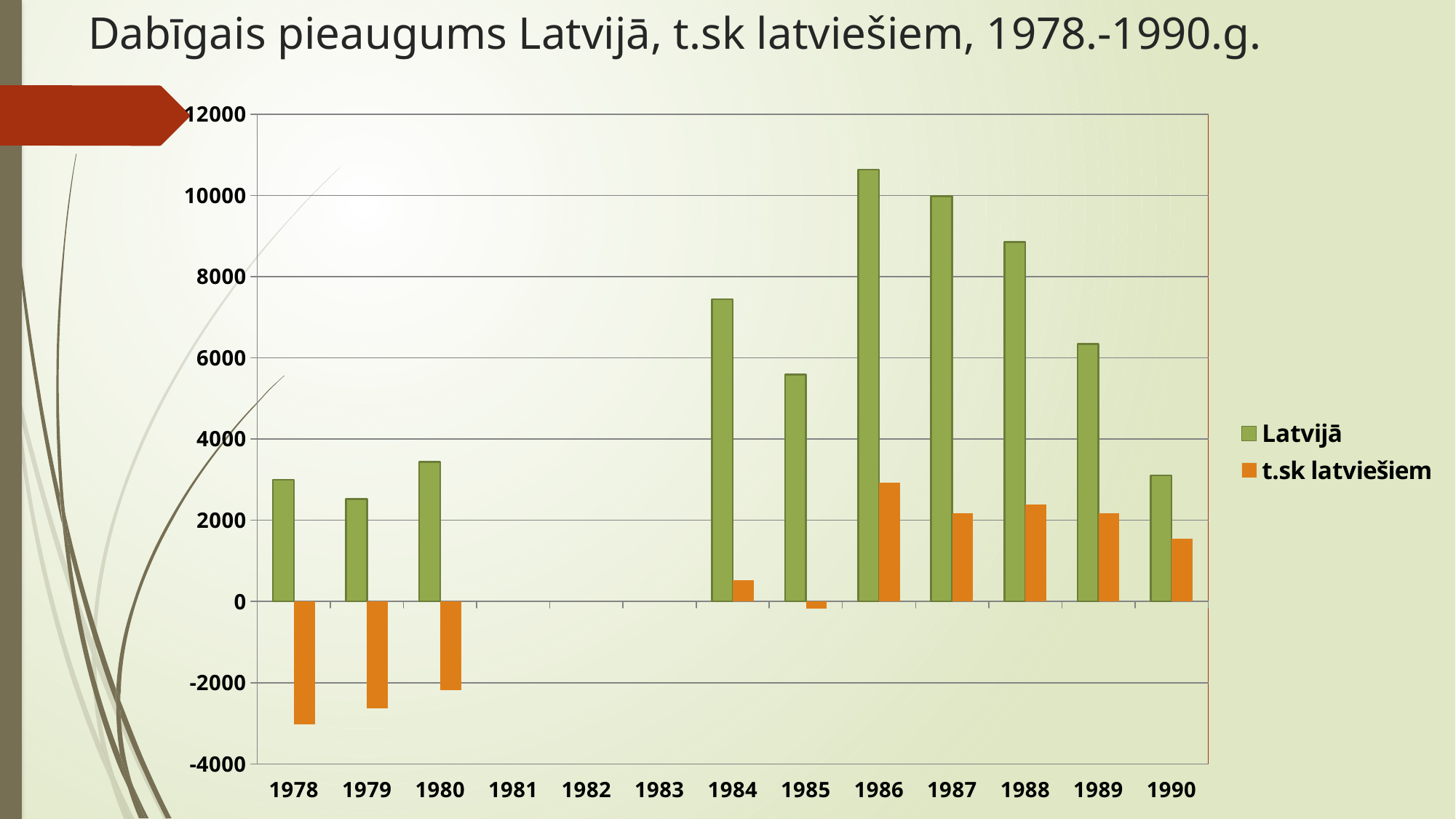
In which year is the t.sk latviešiem value highest? 1986 Is the Latvijā value for 1986 greater or less than 10000? greater Which colour represents the t.sk latviešiem series? orange In which year is the Latvijā value highest? 1986 How many series does the legend list? 2 In which year is the t.sk latviešiem value lowest? 1978 How many years are labelled on the x axis? 13 Do the Latvijā values rise or fall from 1986 to 1990? fall Which is larger, the Latvijā value for 1987 or for 1988? 1987 What kind of chart is shown on the slide? bar chart Is the Latvijā value for 1984 greater or less than 6000? greater Is the t.sk latviešiem value for 1978 greater or less than -2000? less